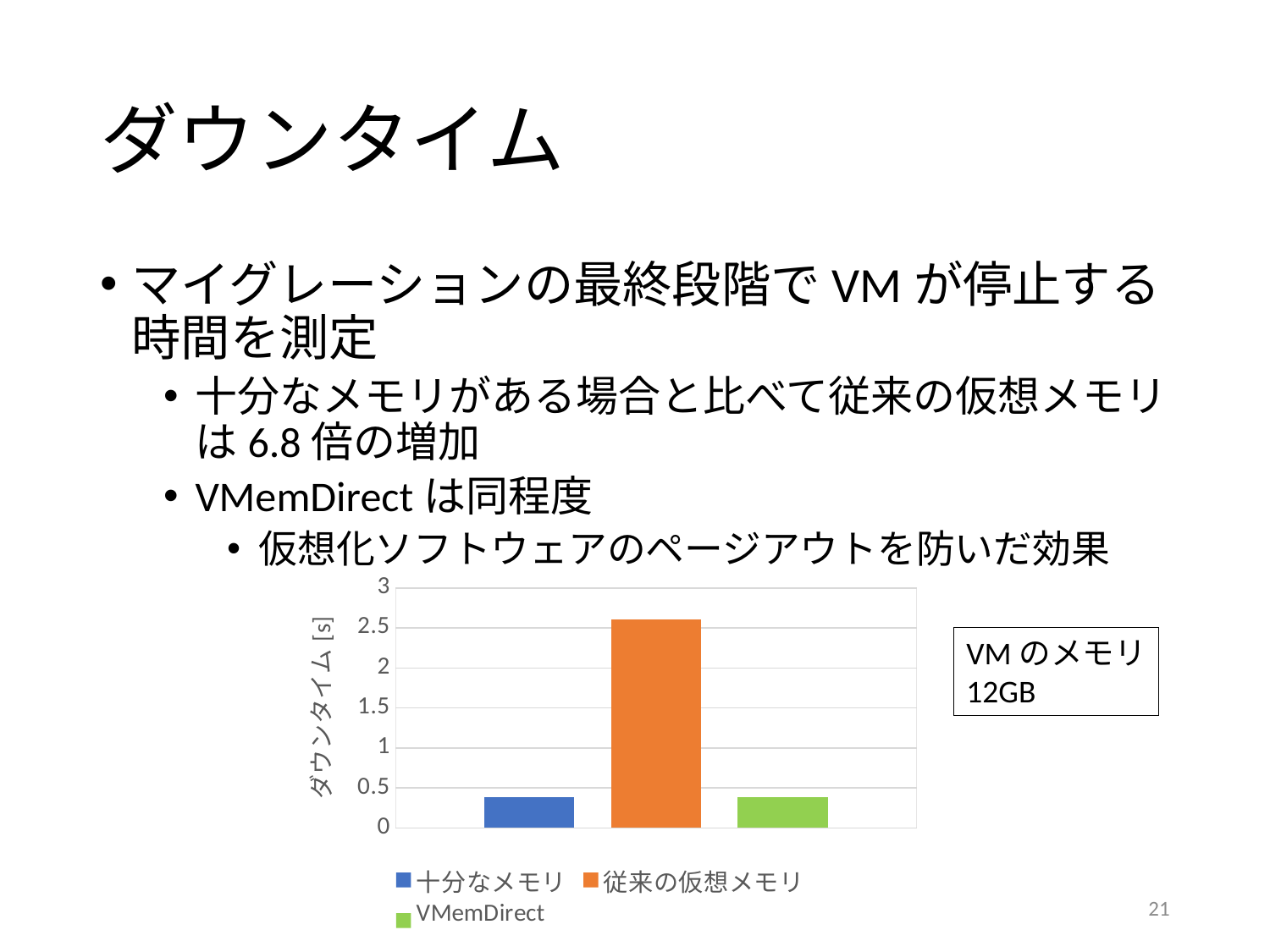
Is the value for 従来の仮想メモリ greater or less than 3? less What is the label of the vertical axis? ダウンタイム [s] What kind of chart is shown on the slide? bar chart Is the value for VMemDirect greater or less than 0.5? less Which is larger, the value for 十分なメモリ or the value for 従来の仮想メモリ? 従来の仮想メモリ Is the value for 従来の仮想メモリ greater or less than 2.5? greater How many series does the legend list? 3 Which is larger, the value for 従来の仮想メモリ or the value for VMemDirect? 従来の仮想メモリ Which series has the highest downtime? 従来の仮想メモリ What colour is the bar for VMemDirect? green